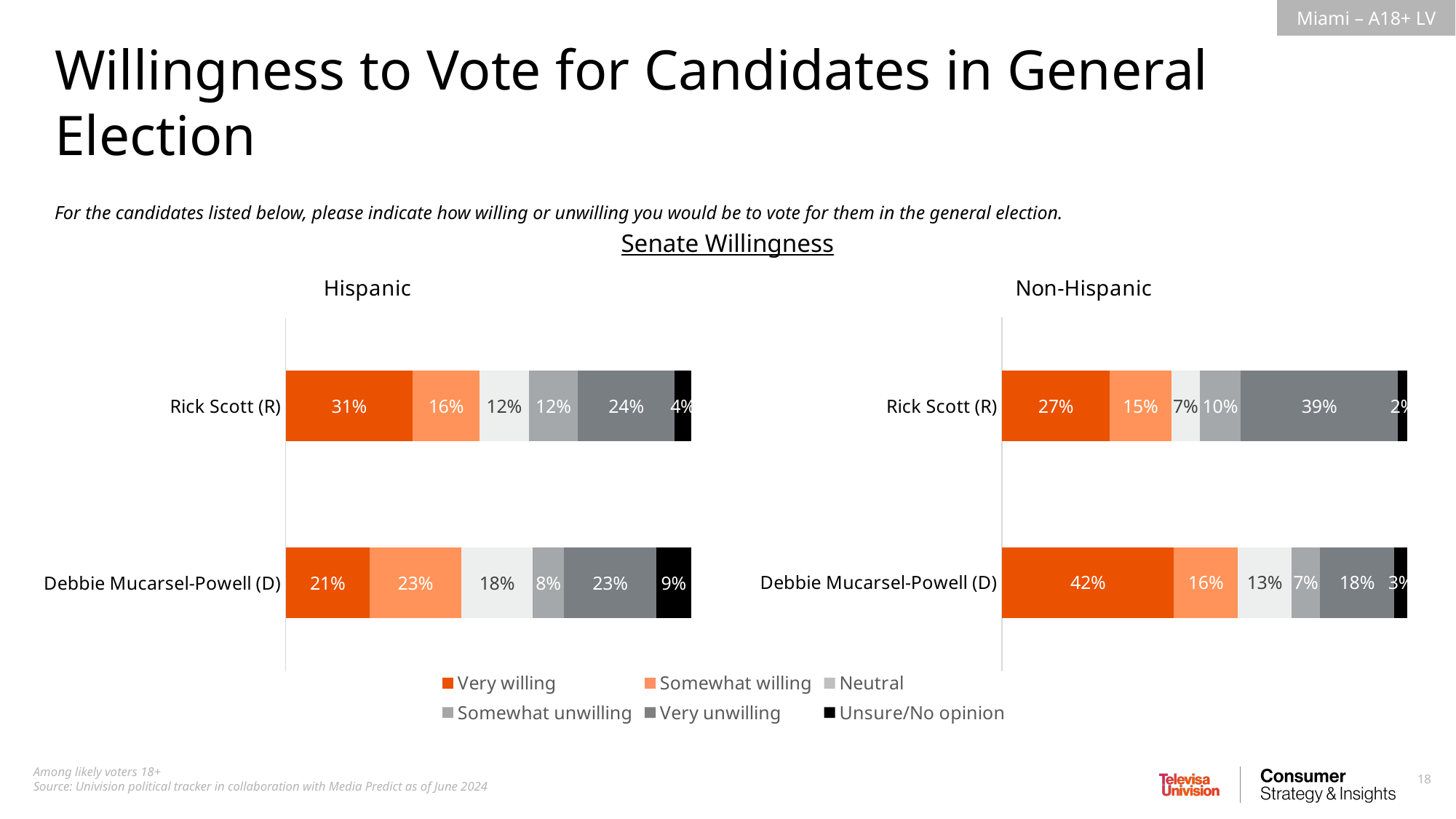
In the Non-Hispanic chart, what percentage of respondents are very willing to vote for Debbie Mucarsel-Powell (D)? 42% How many candidates are shown in the Non-Hispanic chart? 2 In the Non-Hispanic chart, what is the difference between the very willing percentages for Debbie Mucarsel-Powell (D) and Rick Scott (R)? 15% In the Hispanic chart, what percentage of respondents are unsure/no opinion about Debbie Mucarsel-Powell (D)? 9% In the Hispanic chart, which segment is the largest for Debbie Mucarsel-Powell (D)? Somewhat willing and Very unwilling (23% each) In the Hispanic chart, which candidate has the higher very willing percentage? Rick Scott (R) In the Non-Hispanic chart, what percentage of respondents are very unwilling to vote for Rick Scott (R)? 39% In the Non-Hispanic chart, which candidate has the higher very unwilling percentage? Rick Scott (R) How many series does the legend list? 6 In the Hispanic chart, what is the difference between the very willing percentages for Rick Scott (R) and Debbie Mucarsel-Powell (D)? 10% What kind of chart is used for the Hispanic data? Stacked bar chart In the Hispanic chart, what percentage of respondents are very willing to vote for Rick Scott (R)? 31%